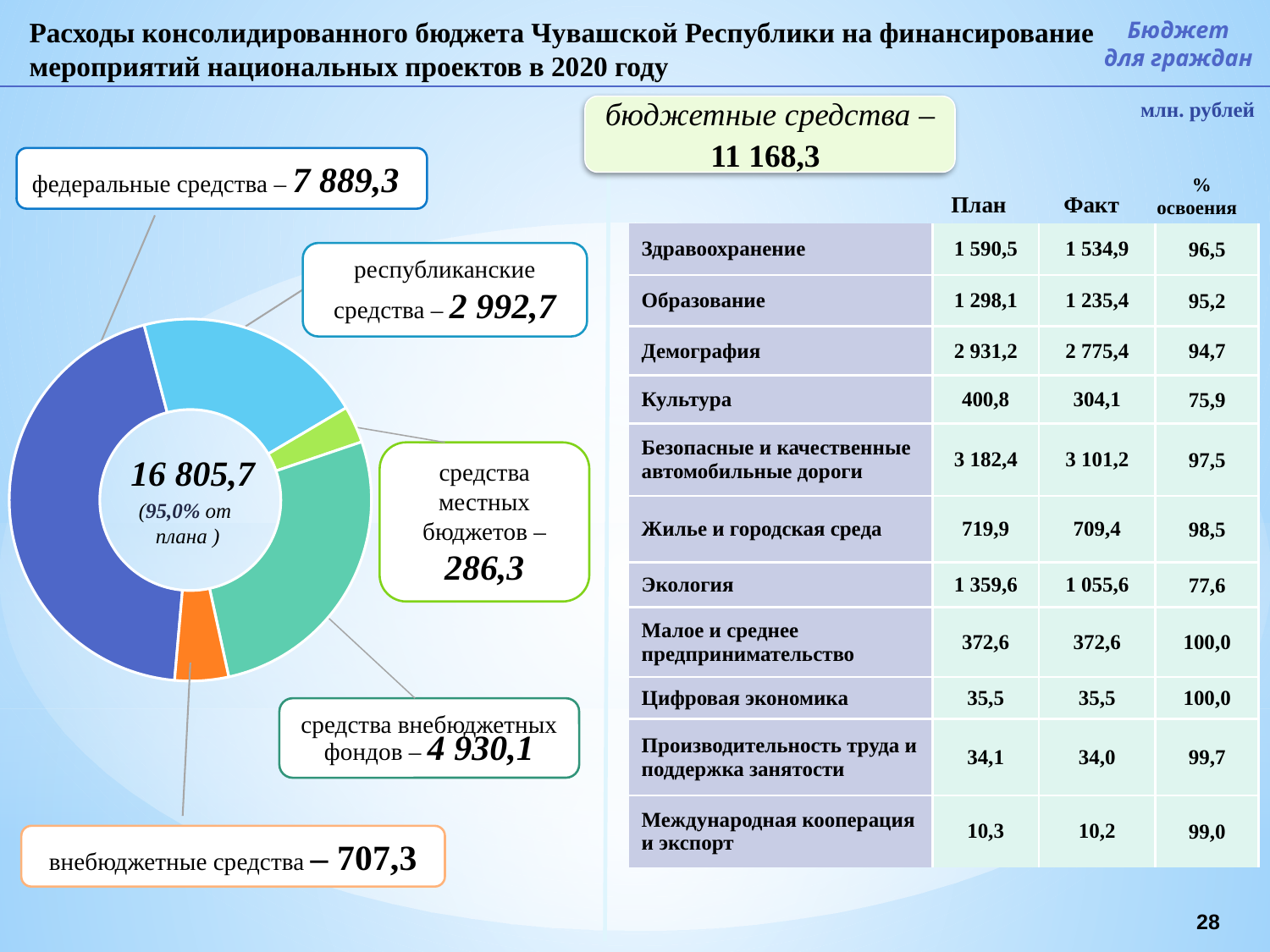
In the doughnut chart, what is the value for внебюджетные средства? 707,3 In the doughnut chart, what is the value for средства внебюджетных фондов? 4 930,1 What total value is shown in the centre of the doughnut chart? 16 805,7 How many segments does the doughnut chart have? 5 In the doughnut chart, what is the value for средства местных бюджетов? 286,3 What kind of chart is shown on the left of the slide? Pie (doughnut) chart In the doughnut chart, what is the value for федеральные средства? 7 889,3 Which source of funds has the largest value in the doughnut chart? федеральные средства In the doughnut chart, what is the difference between федеральные средства and средства внебюджетных фондов? 2 959,2 Which source of funds has the smallest value in the doughnut chart? средства местных бюджетов In the doughnut chart, which is larger: республиканские средства or средства внебюджетных фондов? средства внебюджетных фондов In the doughnut chart, what is the value for республиканские средства? 2 992,7